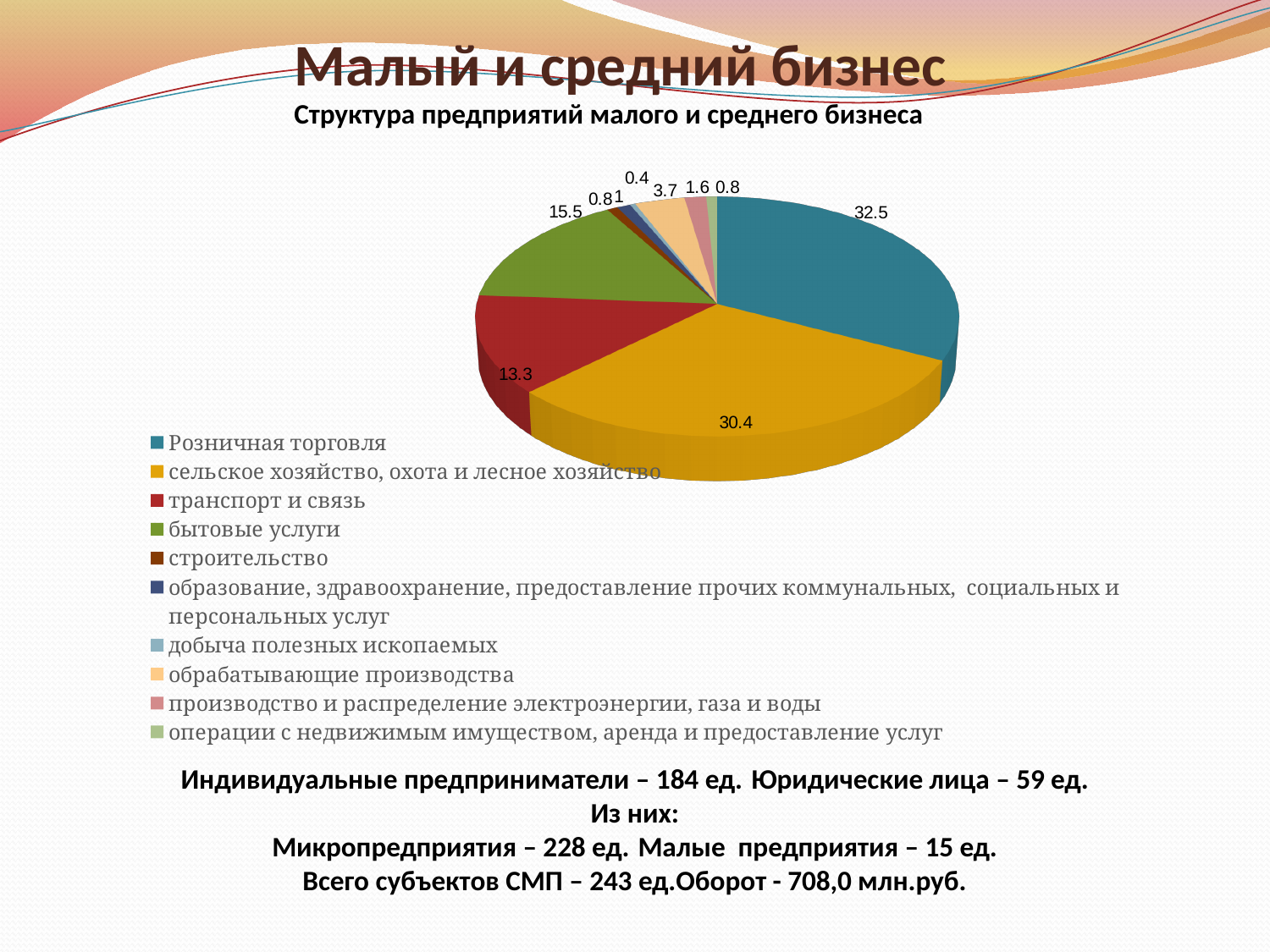
What is the value for бытовые услуги? 15.5 What is the difference between the values for Розничная торговля and сельское хозяйство, охота и лесное хозяйство? 2.1 What kind of chart is shown on the slide? pie chart What is the value for сельское хозяйство, охота и лесное хозяйство? 30.4 What is the value for Розничная торговля? 32.5 Which is larger, бытовые услуги or транспорт и связь? бытовые услуги What is the value for обрабатывающие производства? 3.7 What is the title of the chart? Структура предприятий малого и среднего бизнеса Which category has the largest slice of the pie? Розничная торговля What is the value for транспорт и связь? 13.3 How many categories does the legend list? 10 Which category has the smallest slice of the pie? добыча полезных ископаемых